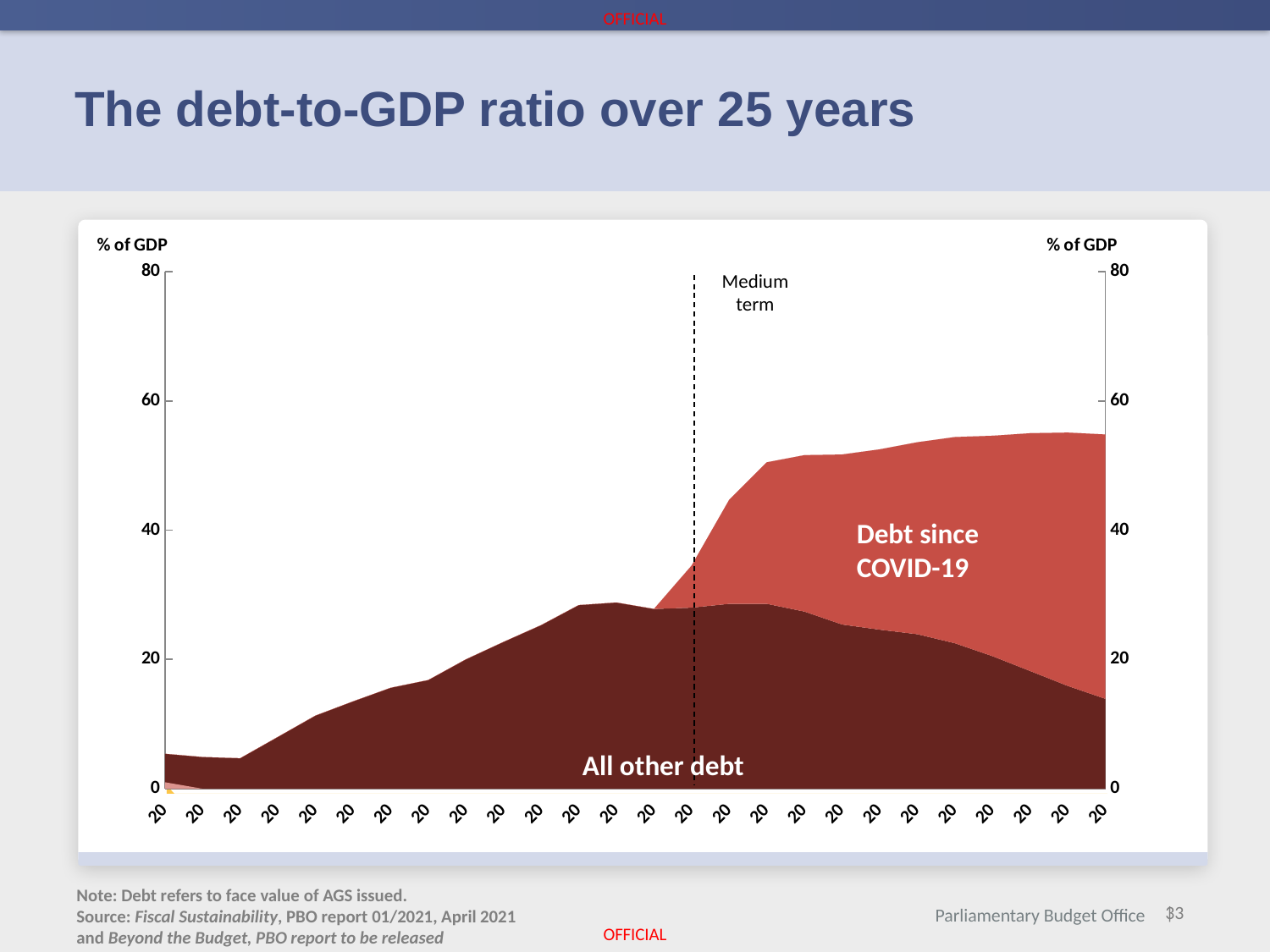
What kind of chart is shown on the slide? Stacked area chart Is the total debt-to-GDP ratio at the left end of the chart greater or less than 20? less What are the names of the two series shown in the chart? All other debt; Debt since COVID-19 Does the 'All other debt' series rise or fall after the 'Medium term' dashed line? fall Is the total debt-to-GDP ratio at the right end of the chart greater or less than 40? greater Is the total debt-to-GDP ratio at the 'Medium term' dashed line greater or less than 20? greater What does the dashed vertical line in the chart mark? Medium term How many debt series are shown in the chart? 2 Which series is larger at the right end of the chart, 'All other debt' or 'Debt since COVID-19'? Debt since COVID-19 Does the total debt-to-GDP ratio rise or fall across the chart from left to right? rise